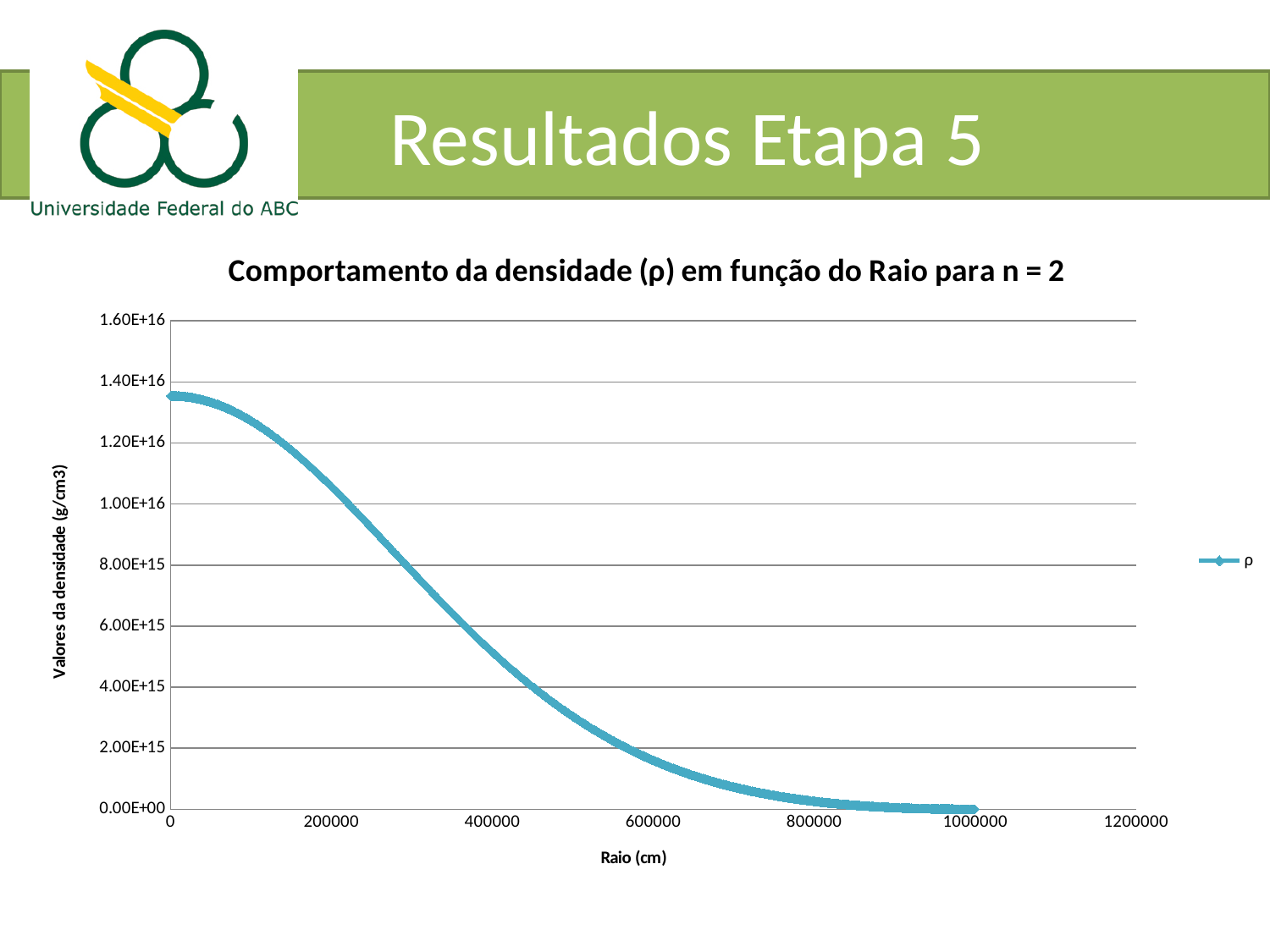
At which radius value on the x axis is the density highest? 0 Is the density value at Raio = 400000 greater or less than 4.00E+15? greater What kind of chart is shown on the slide? scatter chart What is the label of the series shown in the legend? ρ Which is larger, the density value at Raio = 200000 or at Raio = 800000? Raio = 200000 Does the density value rise or fall as the radius (Raio) increases along the x axis? fall Is the density value at Raio = 200000 greater or less than 1.00E+16? greater How many series does the chart legend list? 1 Is the density value at Raio = 800000 greater or less than 2.00E+15? less What is the title of the chart? Comportamento da densidade (ρ) em função do Raio para n = 2